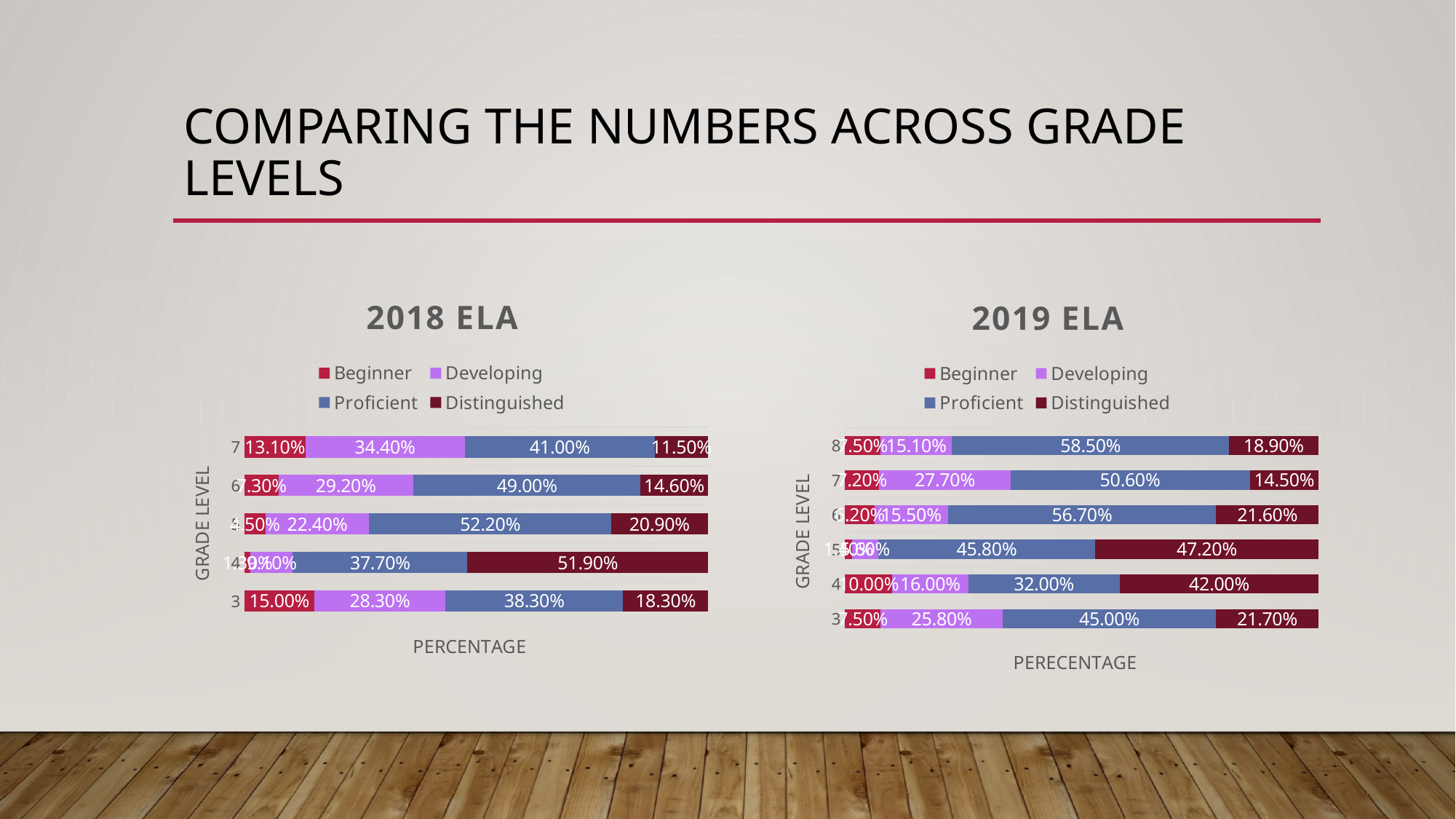
In the 2019 ELA chart, which grade level has the highest Proficient percentage? Grade 8 In the 2018 ELA chart, what is the Distinguished percentage for grade 6? 14.60% In the 2018 ELA chart, which grade has the larger Beginner percentage, grade 3 or grade 7? Grade 3 How many series does the legend of the 2019 ELA chart list? 4 In the 2018 ELA chart, what is the Developing percentage for grade 7? 34.40% What kind of chart is the 2018 ELA chart? Stacked bar chart How many grade levels are shown in the 2019 ELA chart? 6 In the 2019 ELA chart, what is the difference between the Proficient and Distinguished percentages for grade 6? 35.10% In the 2019 ELA chart, what is the difference between the Proficient and Developing percentages for grade 3? 19.20% What is the x-axis title of the 2018 ELA chart? PERCENTAGE In the 2019 ELA chart, what is the Distinguished percentage for grade 4? 42.00% In the 2019 ELA chart, what is the Proficient percentage for grade 8? 58.50%